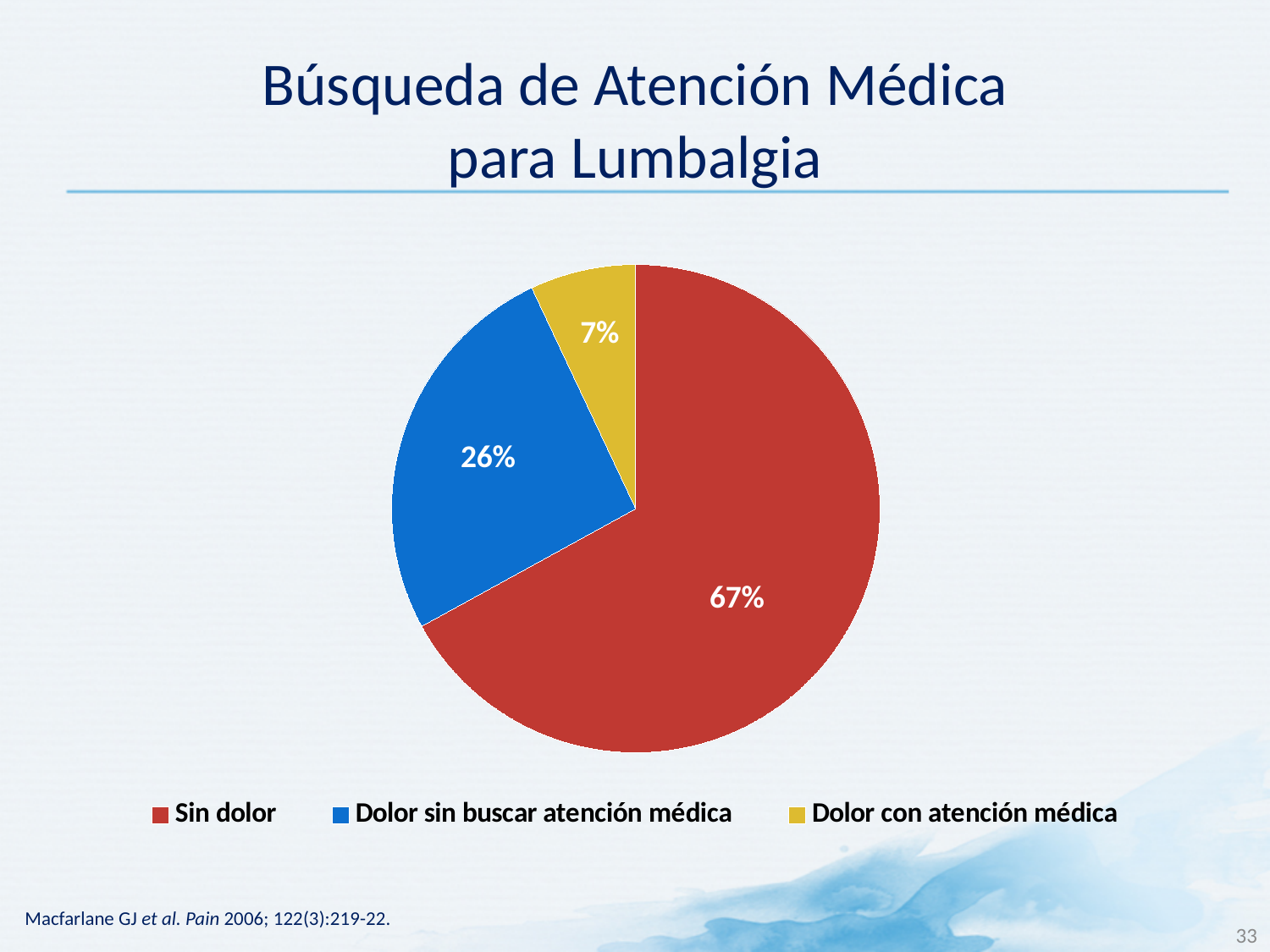
What percentage of the pie is labelled "Sin dolor"? 67% What percentage of the pie is labelled "Dolor con atención médica"? 7% How many slices does the pie chart have? 3 Which is larger: the share for "Dolor sin buscar atención médica" or the share for "Dolor con atención médica"? Dolor sin buscar atención médica What colour is the slice for "Sin dolor"? Red What is the difference in percentage points between "Dolor sin buscar atención médica" and "Dolor con atención médica"? 19 Which category has the smallest share of the pie? Dolor con atención médica What kind of chart is shown on the slide? Pie chart What percentage of the pie is labelled "Dolor sin buscar atención médica"? 26% What is the difference in percentage points between "Sin dolor" and "Dolor sin buscar atención médica"? 41 What is the title of the slide containing the pie chart? Búsqueda de Atención Médica para Lumbalgia Which category has the largest share of the pie? Sin dolor